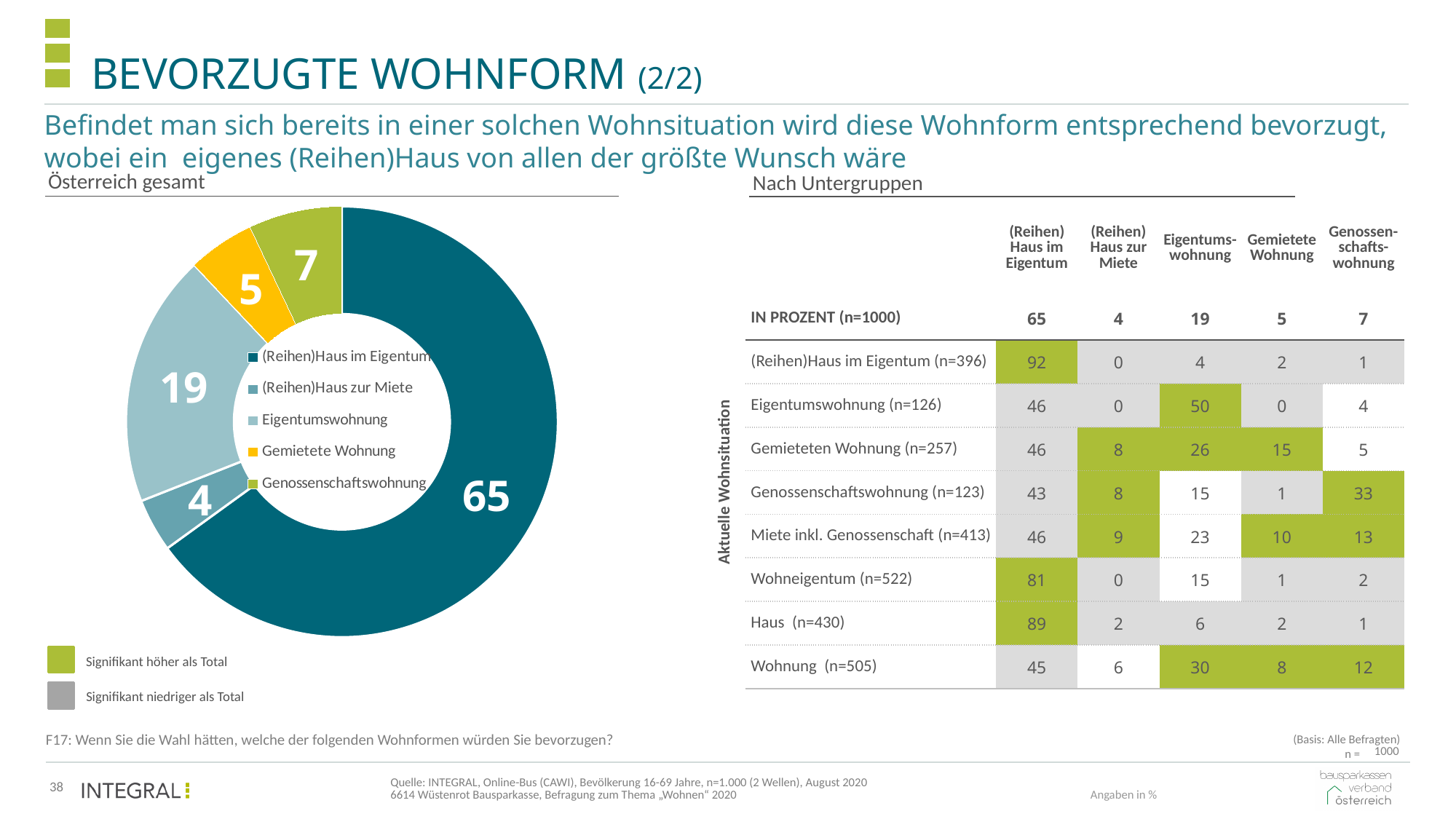
How many categories does the "Österreich gesamt" chart show? 5 In the "Österreich gesamt" chart, which is larger: Gemietete Wohnung or Genossenschaftswohnung? Genossenschaftswohnung In the "Österreich gesamt" chart, what is the value for Eigentumswohnung? 19 In the "Österreich gesamt" chart, what is the value for Genossenschaftswohnung? 7 In the "Österreich gesamt" chart, what is the difference between the values for (Reihen)Haus im Eigentum and Eigentumswohnung? 46 In the "Österreich gesamt" chart, what is the value for (Reihen)Haus zur Miete? 4 In the "Österreich gesamt" chart, which legend entry is shown in yellow? Gemietete Wohnung In the "Österreich gesamt" chart, what is the value for (Reihen)Haus im Eigentum? 65 In the "Österreich gesamt" chart, what is the combined value of Gemietete Wohnung and Genossenschaftswohnung? 12 In the "Österreich gesamt" chart, which category has the largest share? (Reihen)Haus im Eigentum In the "Österreich gesamt" chart, which category has the smallest share? (Reihen)Haus zur Miete What kind of chart is shown under "Österreich gesamt"? Pie chart (donut)